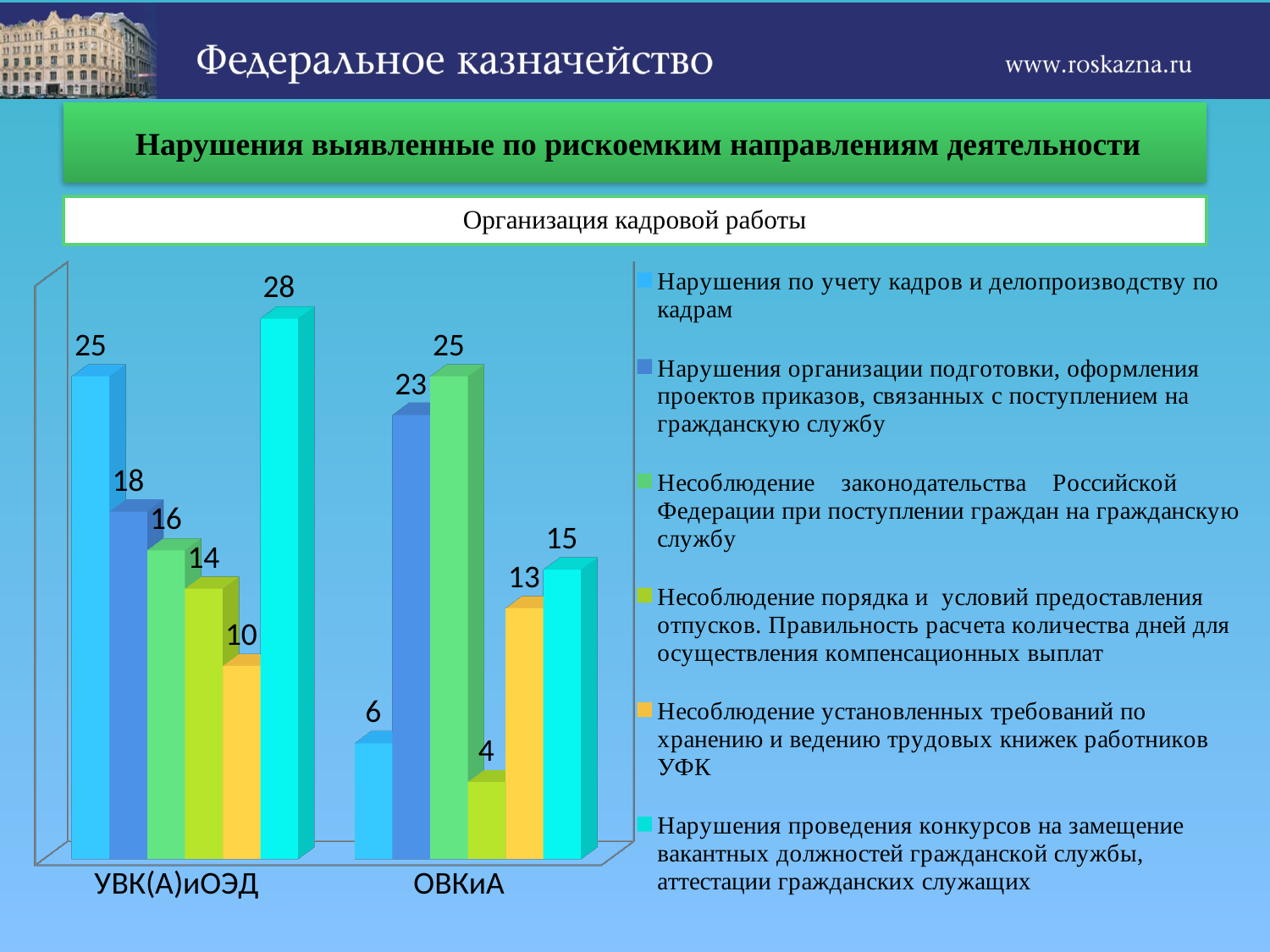
How many categories are shown on the x axis? 2 What type of chart is shown on the slide? Bar chart What is the difference between the values for 'Нарушения организации подготовки, оформления проектов приказов, связанных с поступлением на гражданскую службу' for ОВКиА and УВК(А)иОЭД? 5 What is the total of all six values for ОВКиА? 86 What is the value for 'Нарушения проведения конкурсов на замещение вакантных должностей гражданской службы, аттестации гражданских служащих' for ОВКиА? 15 What is the value for 'Нарушения по учету кадров и делопроизводству по кадрам' for УВК(А)иОЭД? 25 Which series has the lowest value for ОВКиА? Несоблюдение порядка и условий предоставления отпусков. Правильность расчета количества дней для осуществления компенсационных выплат Which series has the highest value for УВК(А)иОЭД? Нарушения проведения конкурсов на замещение вакантных должностей гражданской службы, аттестации гражданских служащих What is the subtitle shown above the chart? Организация кадровой работы Which category has the larger value for 'Несоблюдение законодательства Российской Федерации при поступлении граждан на гражданскую службу'? ОВКиА What is the value for 'Несоблюдение установленных требований по хранению и ведению трудовых книжек работников УФК' for УВК(А)иОЭД? 10 How many series does the legend list? 6